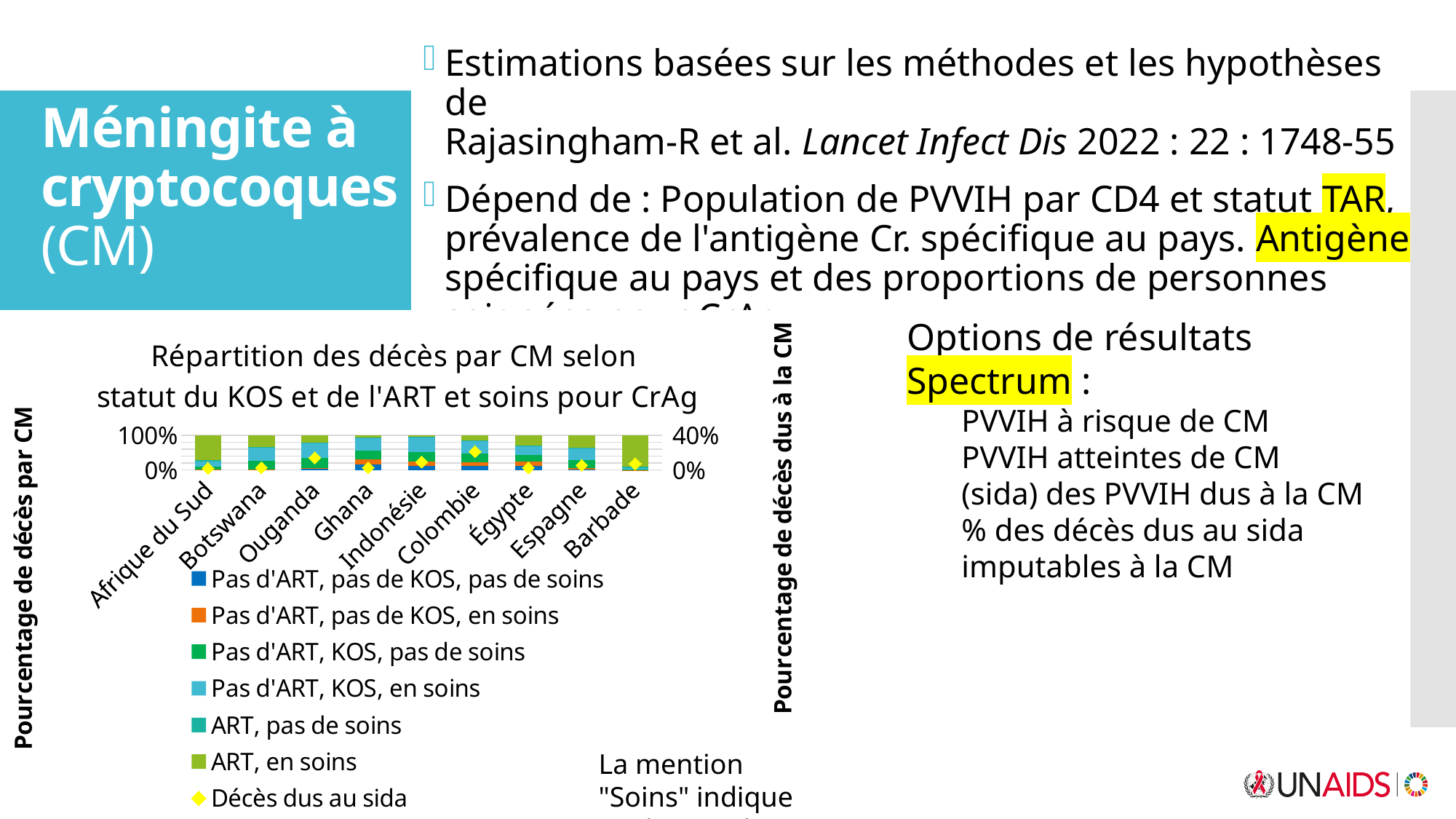
What is the total of the stacked bar for Botswana? 100% What is the label of the left vertical axis of the chart? Pourcentage de décès par CM Which legend series is plotted as yellow diamond markers? Décès dus au sida How many countries are shown on the x axis of the chart? 9 Which country has the highest value for the 'Décès dus au sida' marker series? Colombie How many entries does the chart legend list? 7 Which country is the last category on the x axis of the chart? Barbade What is the maximum value shown on the right-hand vertical axis of the chart? 40% What is the title of the chart? Répartition des décès par CM selon statut du KOS et de l'ART et soins pour CrAg Is the 'Décès dus au sida' value for Barbade greater or less than 20%? less Which country is the first category on the x axis of the chart? Afrique du Sud What kind of chart is shown on the slide? Stacked bar chart